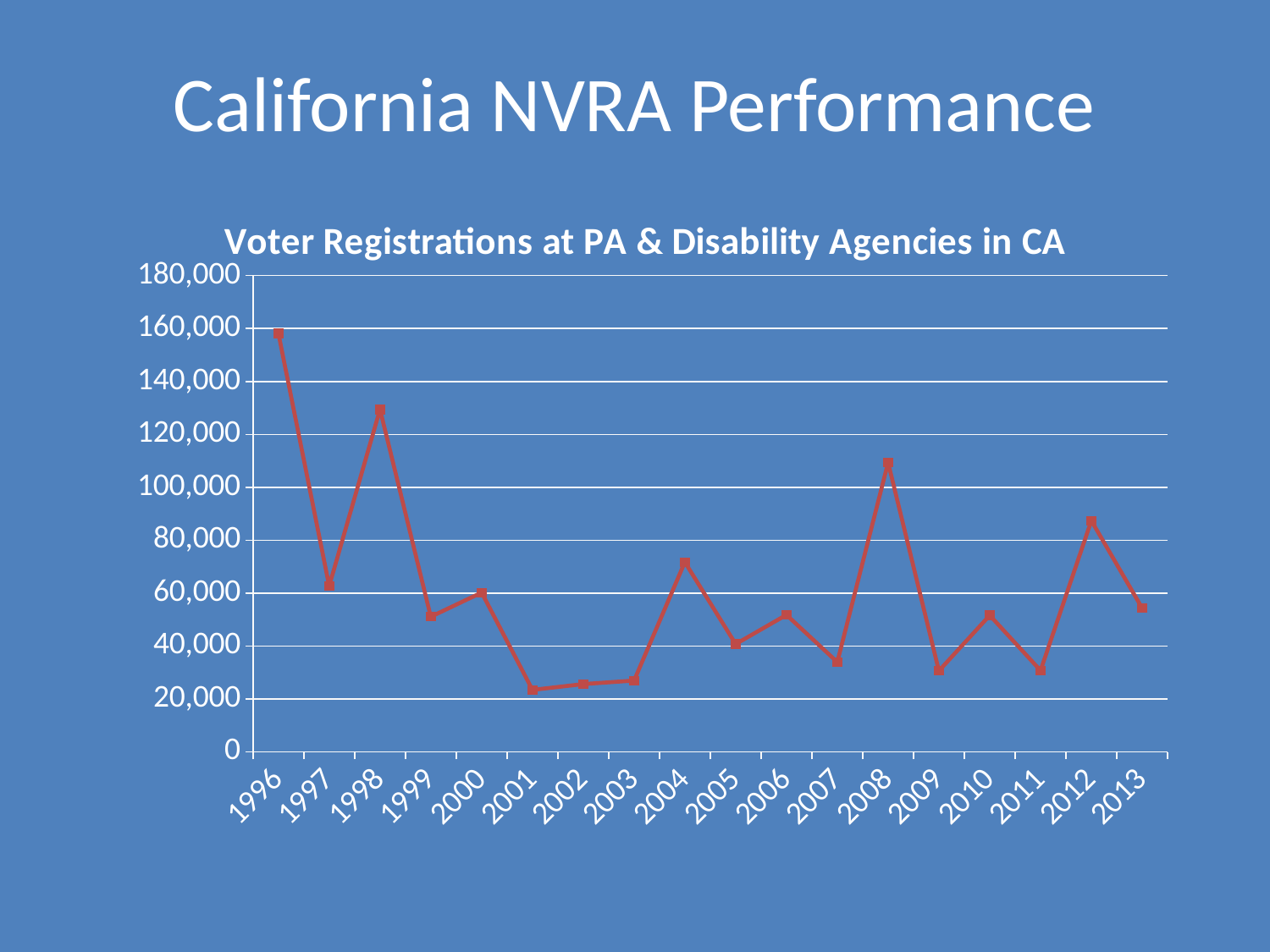
Which year has the larger value, 2005 or 2006? 2006 What is the title of the chart? Voter Registrations at PA & Disability Agencies in CA How many years are plotted on the x axis of the chart? 18 Is the value for 2001 greater or less than 40,000? less Which year has the larger value, 1998 or 2008? 1998 Is the value for 1998 greater or less than 120,000? greater Which year has the highest number of voter registrations? 1996 What kind of chart is shown on the slide? line chart Overall, do voter registrations rise or fall from 1996 to 2013? fall Is the value for 1996 greater or less than 140,000? greater